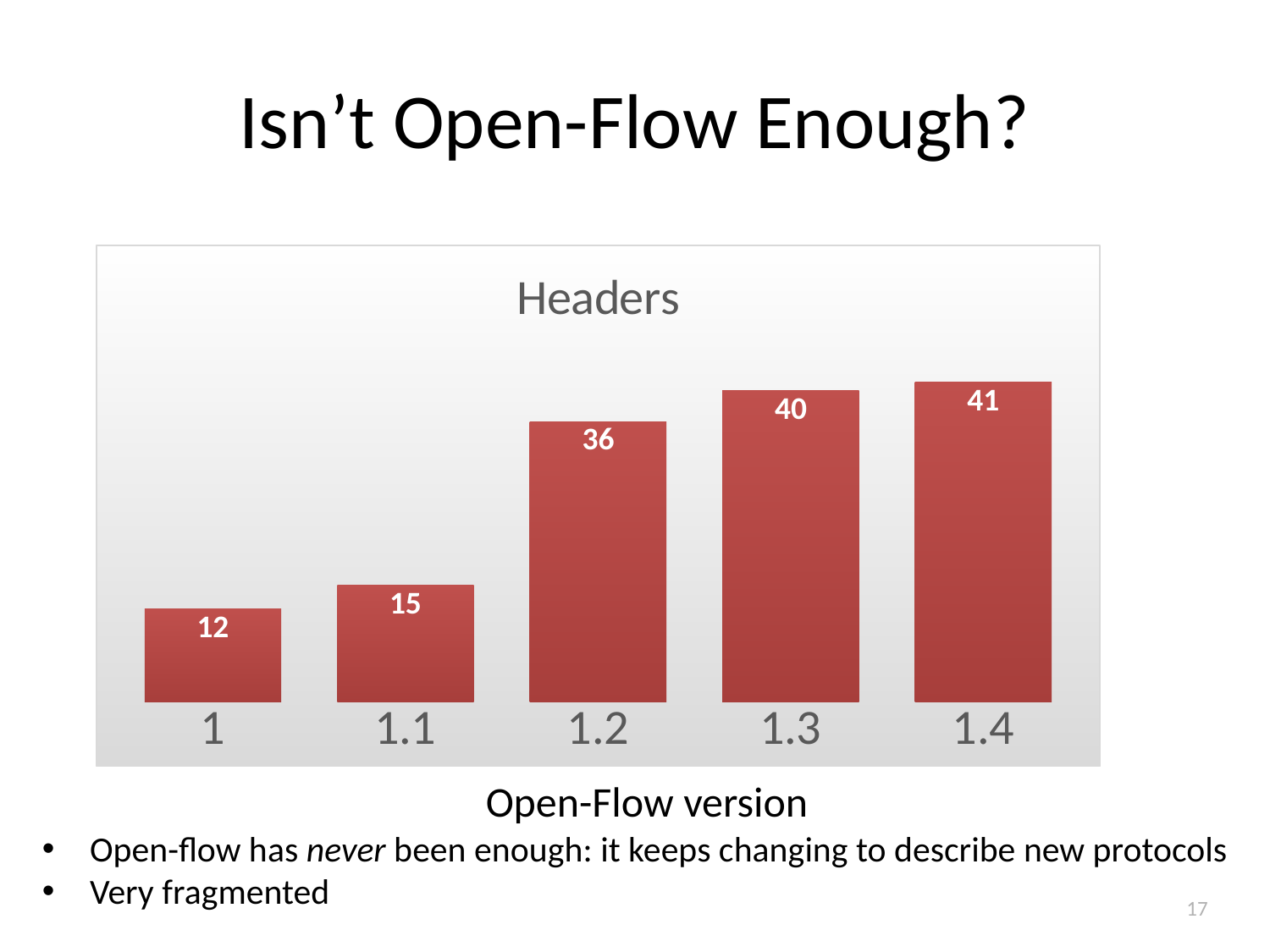
What is the number of headers for Open-Flow version 1.2? 36 How many Open-Flow versions are shown in the chart? 5 What is the difference in headers between version 1.2 and version 1.1? 21 What is the number of headers for Open-Flow version 1? 12 Which Open-Flow version has the lowest number of headers? 1 Which Open-Flow version has the highest number of headers? 1.4 What is the title of the chart? Headers What is the difference in headers between version 1.4 and version 1? 29 What kind of chart is shown on the slide? Bar chart Which has more headers, version 1.3 or version 1.1? 1.3 Do the header counts rise or fall as the Open-Flow version increases? Rise What is the number of headers for Open-Flow version 1.4? 41